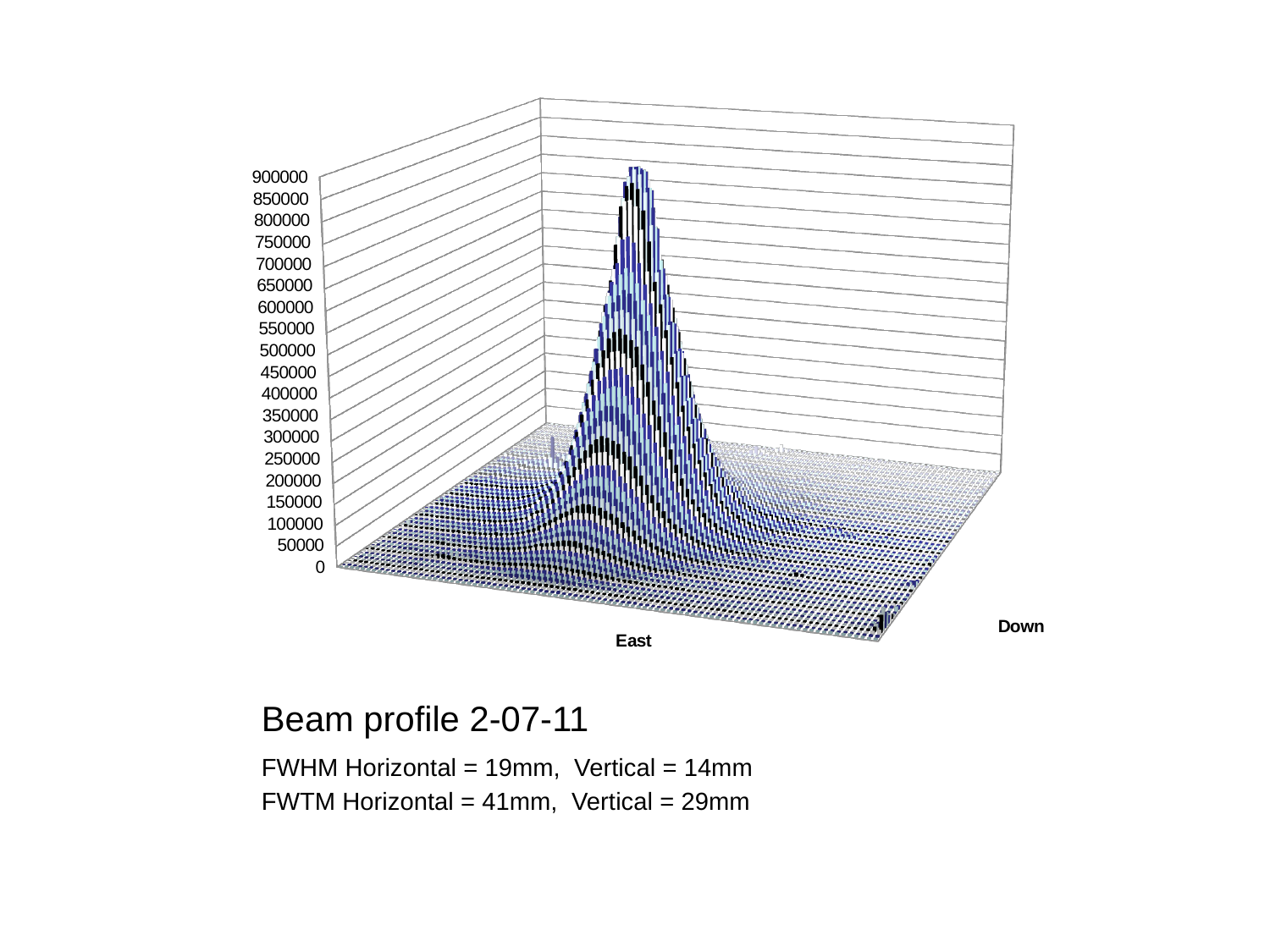
What is the highest tick value shown on the vertical axis of the chart? 900000 Are the values at the far edges of the chart's base greater or less than 100000? less What is the lowest tick value shown on the vertical axis of the chart? 0 What is the interval between consecutive tick labels on the vertical axis? 50000 Is the peak value of the beam profile greater or less than 500000? greater Is the peak value of the beam profile greater or less than 300000? greater How many tick labels are printed on the vertical axis of the chart? 19 What kind of chart is shown on the slide? 3D bar chart